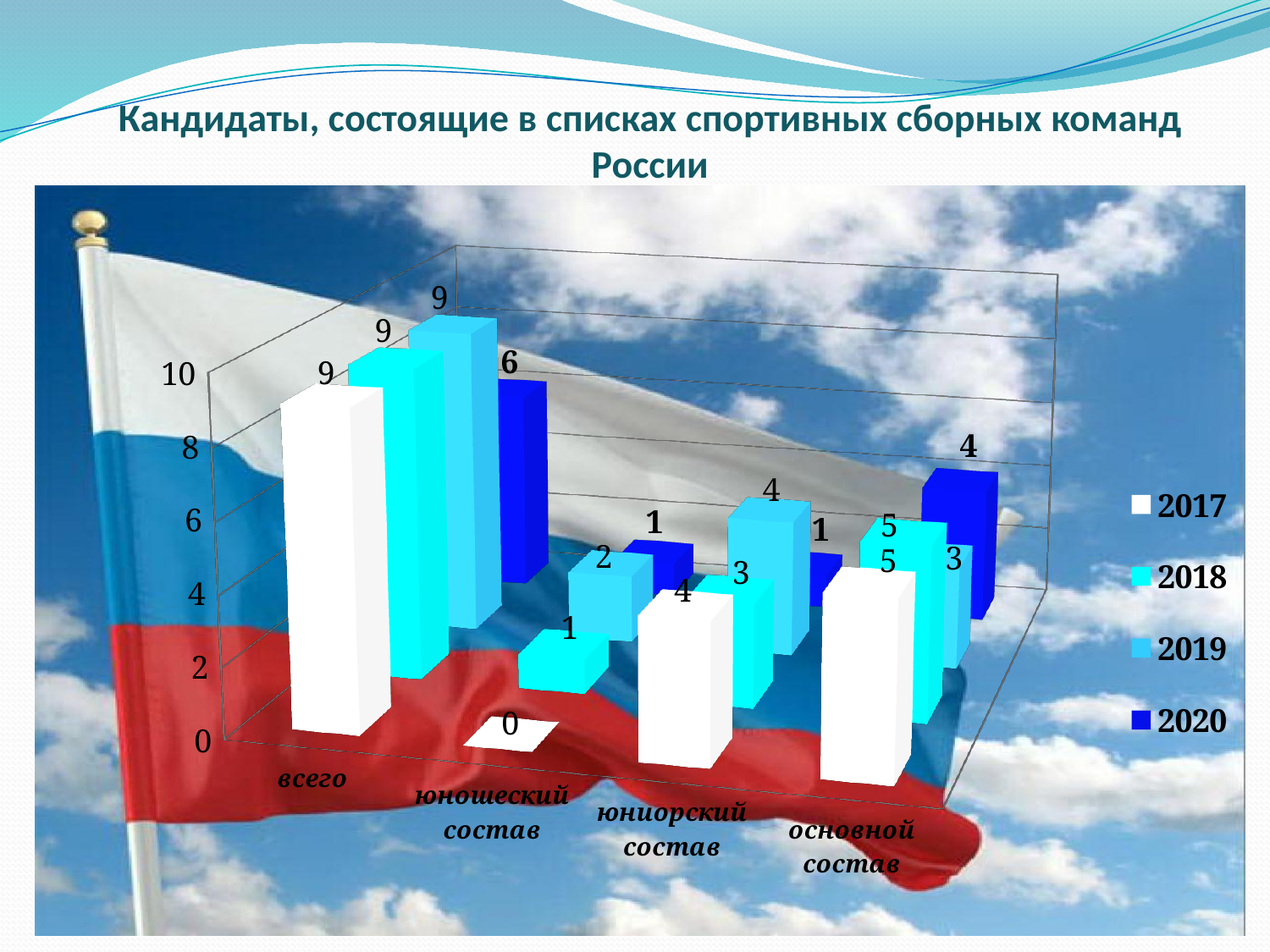
What is the value for 2017 in the "всего" category? 9 What is the value for 2017 in the "юношеский состав" category? 0 What is the difference between the 2017 and 2020 values in the "всего" category? 3 What is the value for 2020 in the "всего" category? 6 What kind of chart is shown on the slide? bar chart Which category has the highest value for 2018? всего Which category has the lowest value for 2017? юношеский состав Which is larger in the "основной состав" category: the 2018 value or the 2019 value? 2018 What is the value for 2019 in the "юниорский состав" category? 4 How many categories are shown on the x axis? 4 What is the value for 2020 in the "основной состав" category? 4 How many series does the legend list? 4